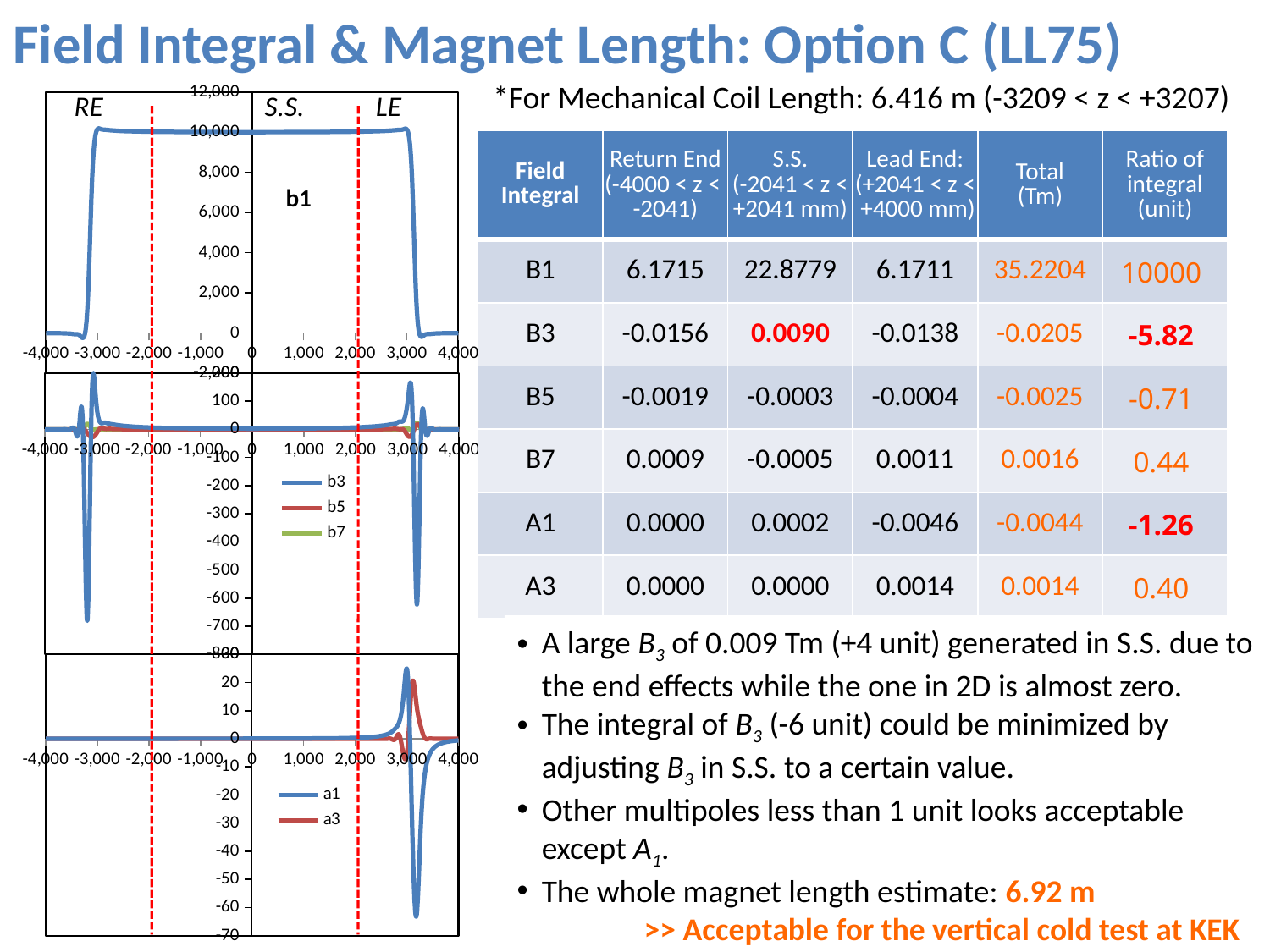
How many series does the legend of the bottom chart on the left list? 2 How many series does the legend of the middle chart on the left list? 3 In the bottom chart on the left, is the minimum value of a1 near z = 3,000 greater or less than -40? less In the top chart on the left, is the value of b1 at z = 0 greater or less than 8,000? greater In the bottom chart on the left, which series are listed in the legend? a1, a3 In the top chart on the left, is the value of b1 at z = -4,000 greater or less than 2,000? less In the middle chart on the left, which series are listed in the legend? b3, b5, b7 How many charts are shown on the left side of the slide? 3 What kind of chart is the top chart on the left of the slide (the one labelled b1)? line chart